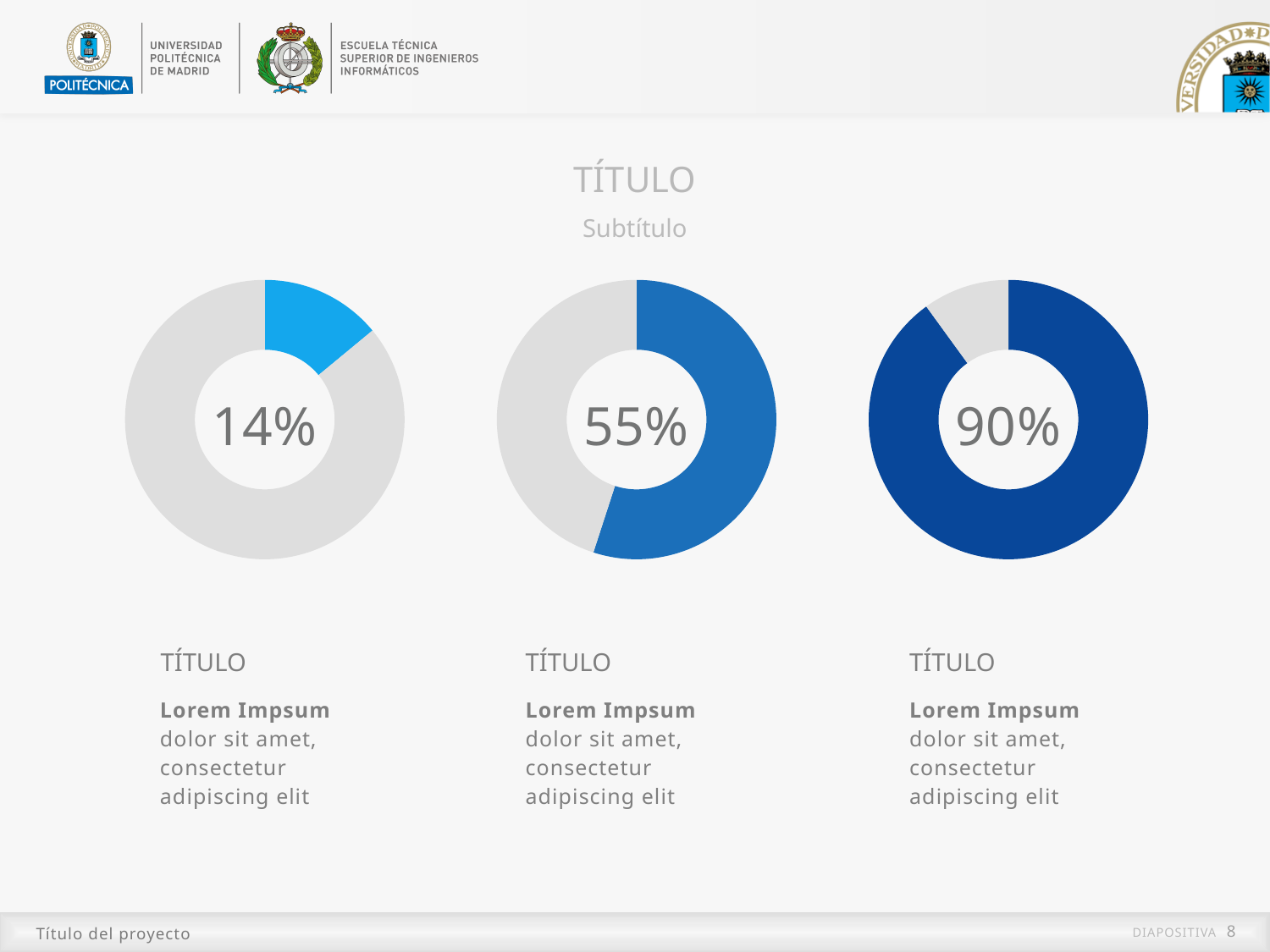
What is the difference between the percentage in the middle donut chart and the percentage in the left donut chart? 41% What value is shown in the centre of the left donut chart? 14% What is the difference between the percentage in the right donut chart and the percentage in the left donut chart? 76% What value is shown in the centre of the right donut chart? 90% What value is shown in the centre of the middle donut chart? 55% What colour is the filled portion of the left donut chart? light blue How many donut charts are on the slide? 3 What kind of chart is used on the slide? donut chart Is the percentage in the middle donut chart greater or less than 50%? greater Which is larger, the percentage in the middle donut chart or the percentage in the right donut chart? right Which of the three donut charts shows the lowest percentage: left, middle or right? left Which of the three donut charts shows the highest percentage: left, middle or right? right